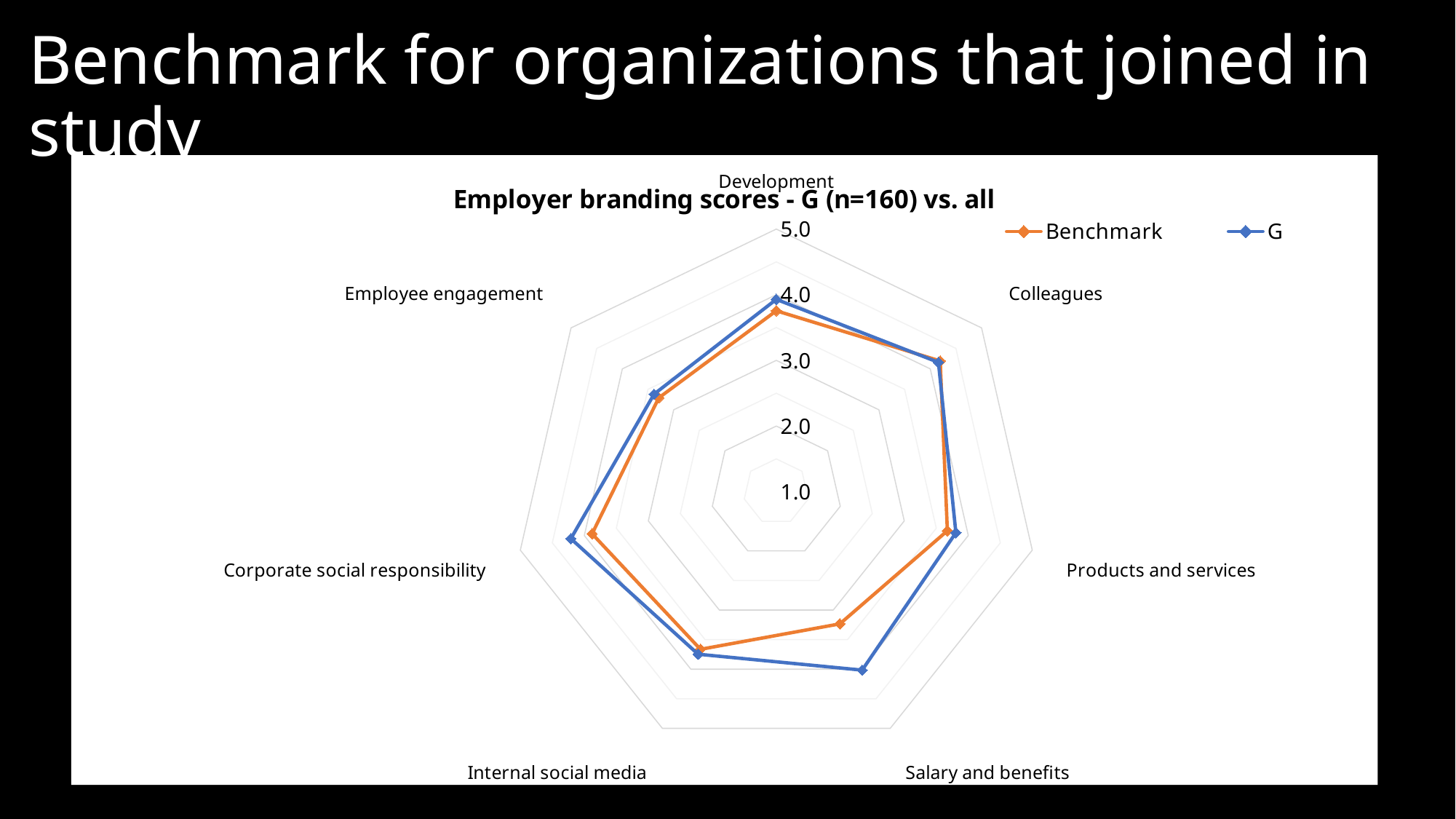
For Salary and benefits, which series has the larger value, Benchmark or G? G Which series is drawn in orange? Benchmark How many categories are plotted around the radar chart? 7 Is the G value for Corporate social responsibility greater or less than 3.0? greater Is the Benchmark value for Salary and benefits greater or less than 4.0? less Is the Benchmark value for Employee engagement greater or less than 4.0? less What kind of chart is shown on the slide? Radar chart How many series does the legend list? 2 What is the title of the chart? Employer branding scores - G (n=160) vs. all